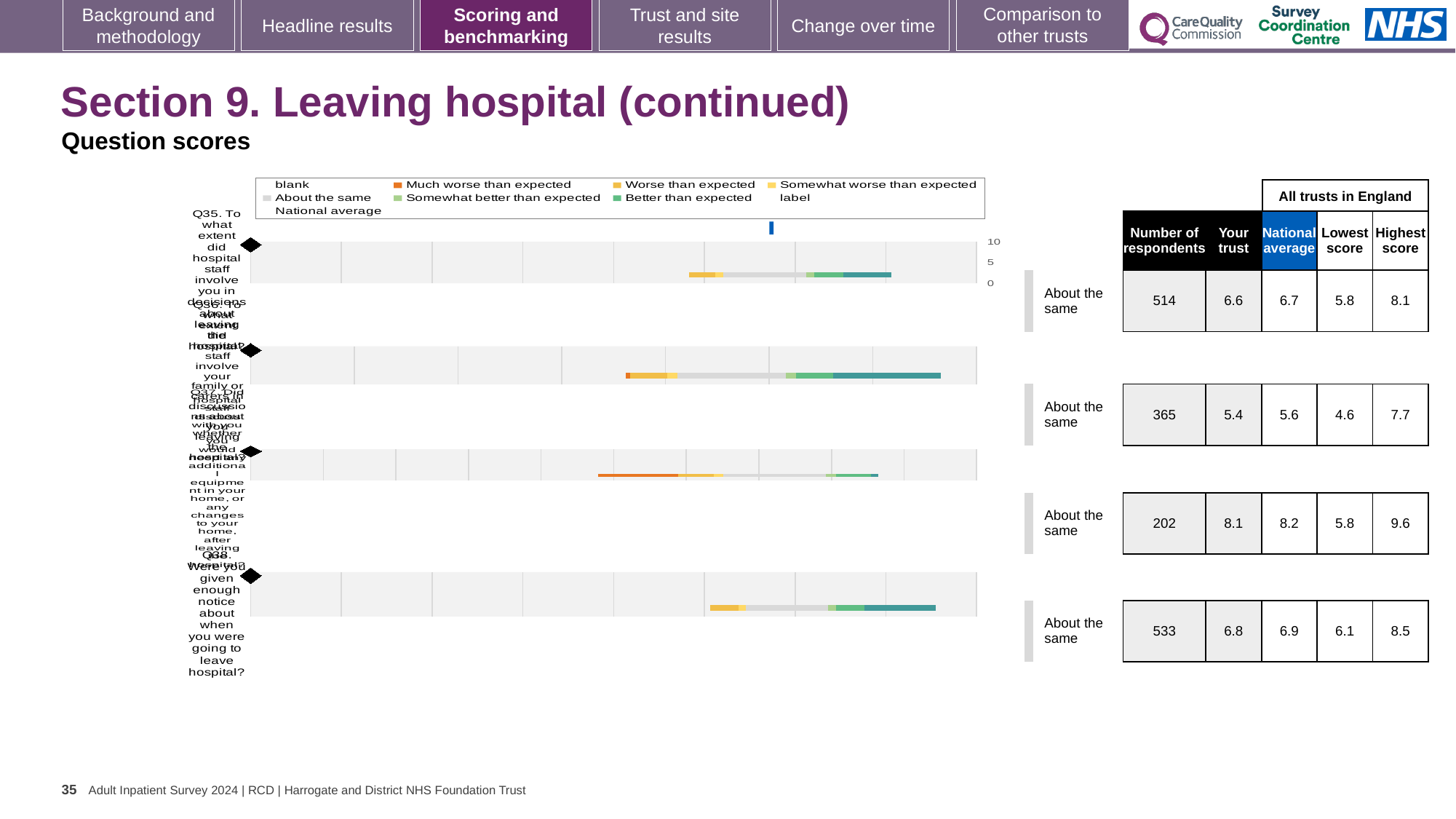
What is the difference between the national average and the 'Your trust' score for Q35? 0.1 How many entries does the chart legend list? 9 What benchmark category is shown next to each of the four question bars? About the same In the table beside the chart, what is the 'Your trust' score for Q35? 6.6 Which question has the lowest 'Your trust' score in the table beside the chart? Q36 For Q38, which is larger: the 'Your trust' score or the national average? National average How many question bars are plotted in the chart? 4 In the table beside the chart, how many respondents are listed for Q38? 533 What colour represents 'Much worse than expected' in the chart legend? orange Which question has the highest 'Your trust' score in the table beside the chart? Q37 What kind of chart is shown on the slide? bar chart What colour represents 'Better than expected' in the chart legend? teal